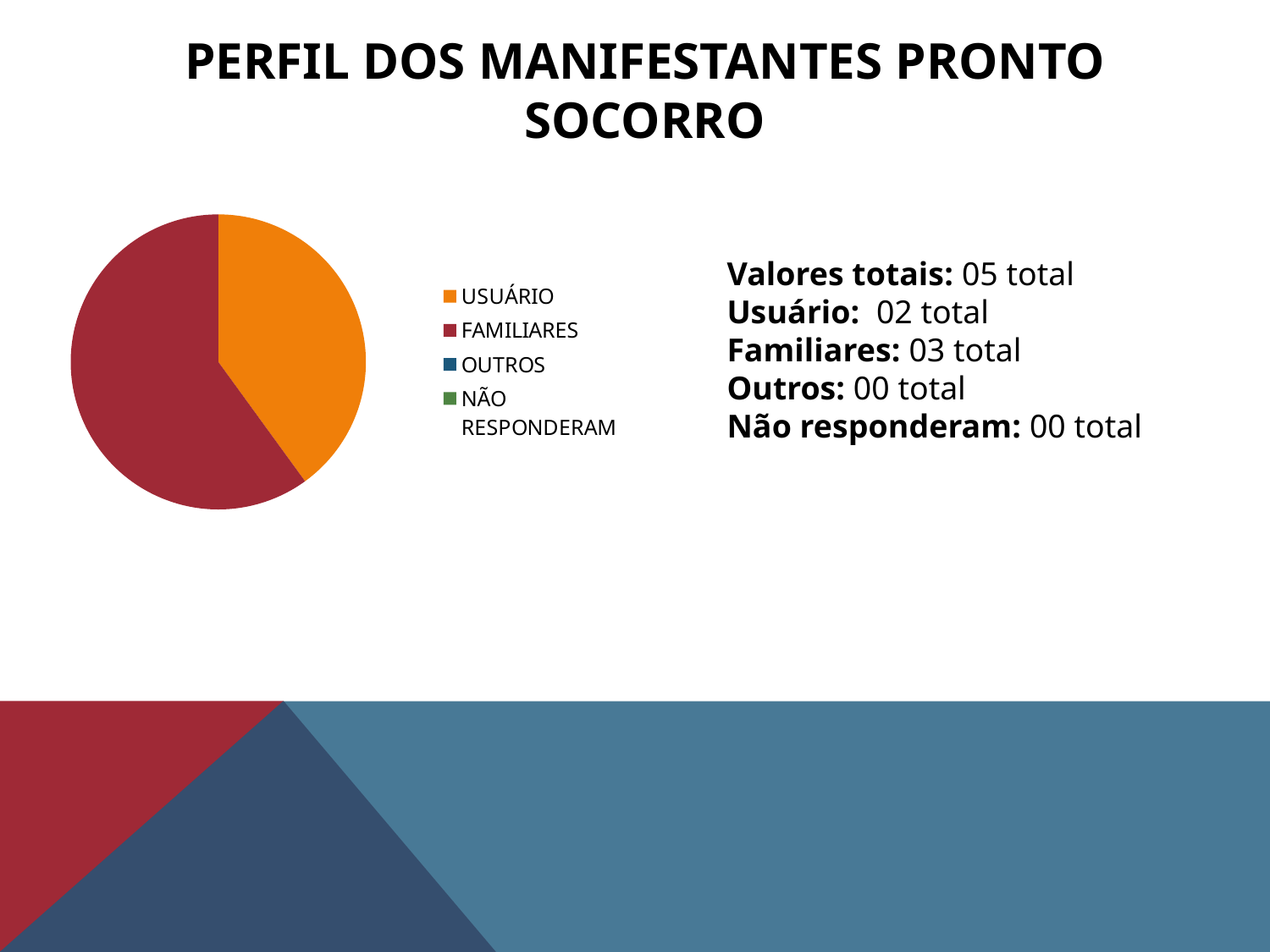
What colour is the USUÁRIO slice in the pie chart? Orange What is the difference between the Familiares and Usuário counts? 01 What kind of chart is shown on the slide? Pie chart According to the slide, how many manifestantes are Familiares? 03 How many categories does the pie chart's legend list? 4 According to the slide, how many manifestantes are Usuário? 02 According to the slide, how many manifestantes are Outros? 00 Which is larger in the pie chart, USUÁRIO or FAMILIARES? FAMILIARES Which category has the largest slice of the pie chart? FAMILIARES What share of the pie does FAMILIARES represent? 60% What is the total number of manifestantes given on the slide (Valores totais)? 05 What is the title of the slide containing the pie chart? PERFIL DOS MANIFESTANTES PRONTO SOCORRO